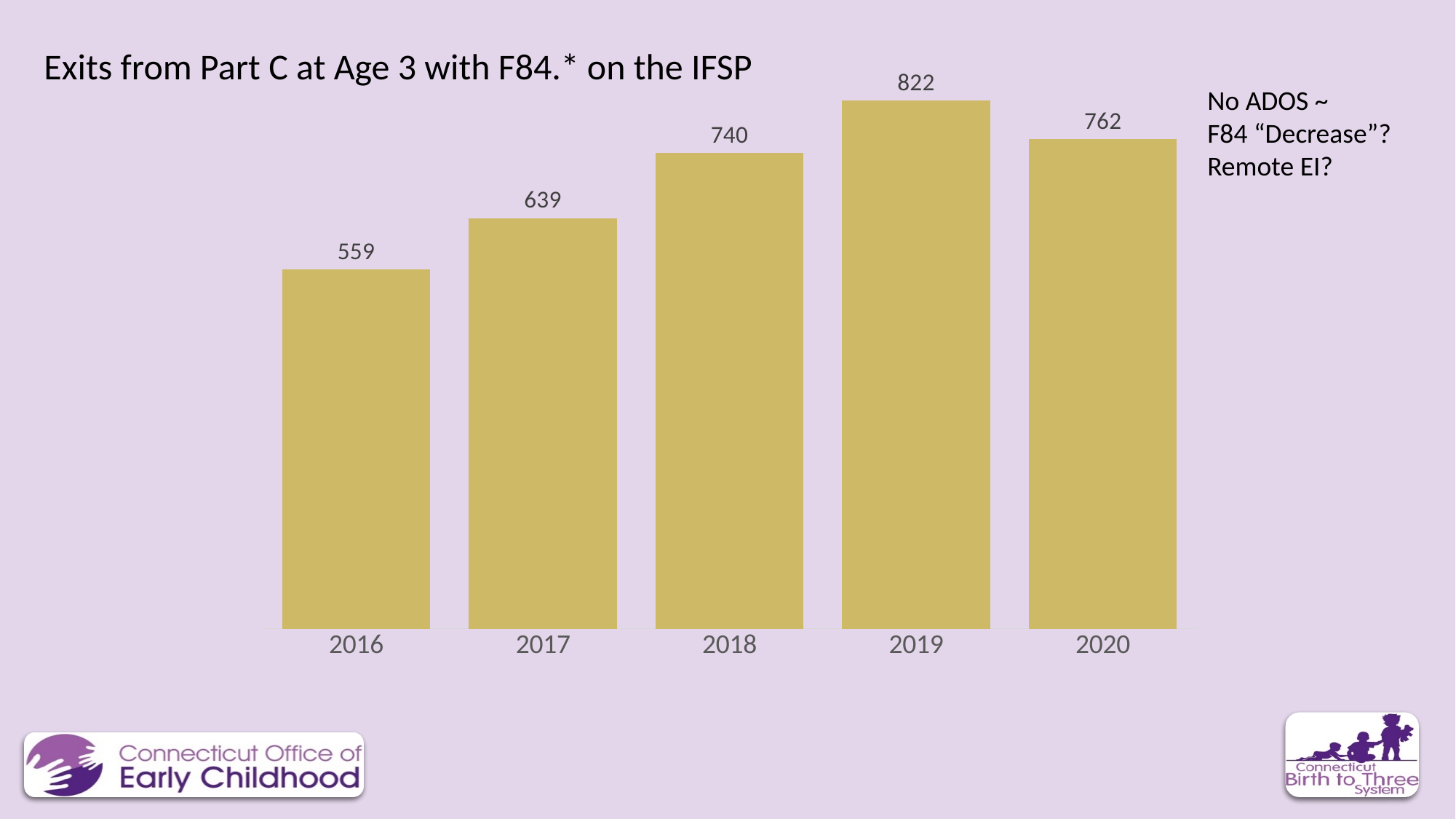
What is the title of the chart? Exits from Part C at Age 3 with F84.* on the IFSP What kind of chart is shown on the slide? Bar chart How many years are shown on the chart? 5 What is the value for 2020? 762 What is the value for 2019? 822 Which year has the lowest value? 2016 Which is larger, the value for 2018 or the value for 2020? 2020 What is the difference between the values for 2017 and 2016? 80 What is the difference between the values for 2019 and 2020? 60 Do the values rise or fall from 2016 to 2019? Rise Which year has the highest value? 2019 What is the value for 2016? 559